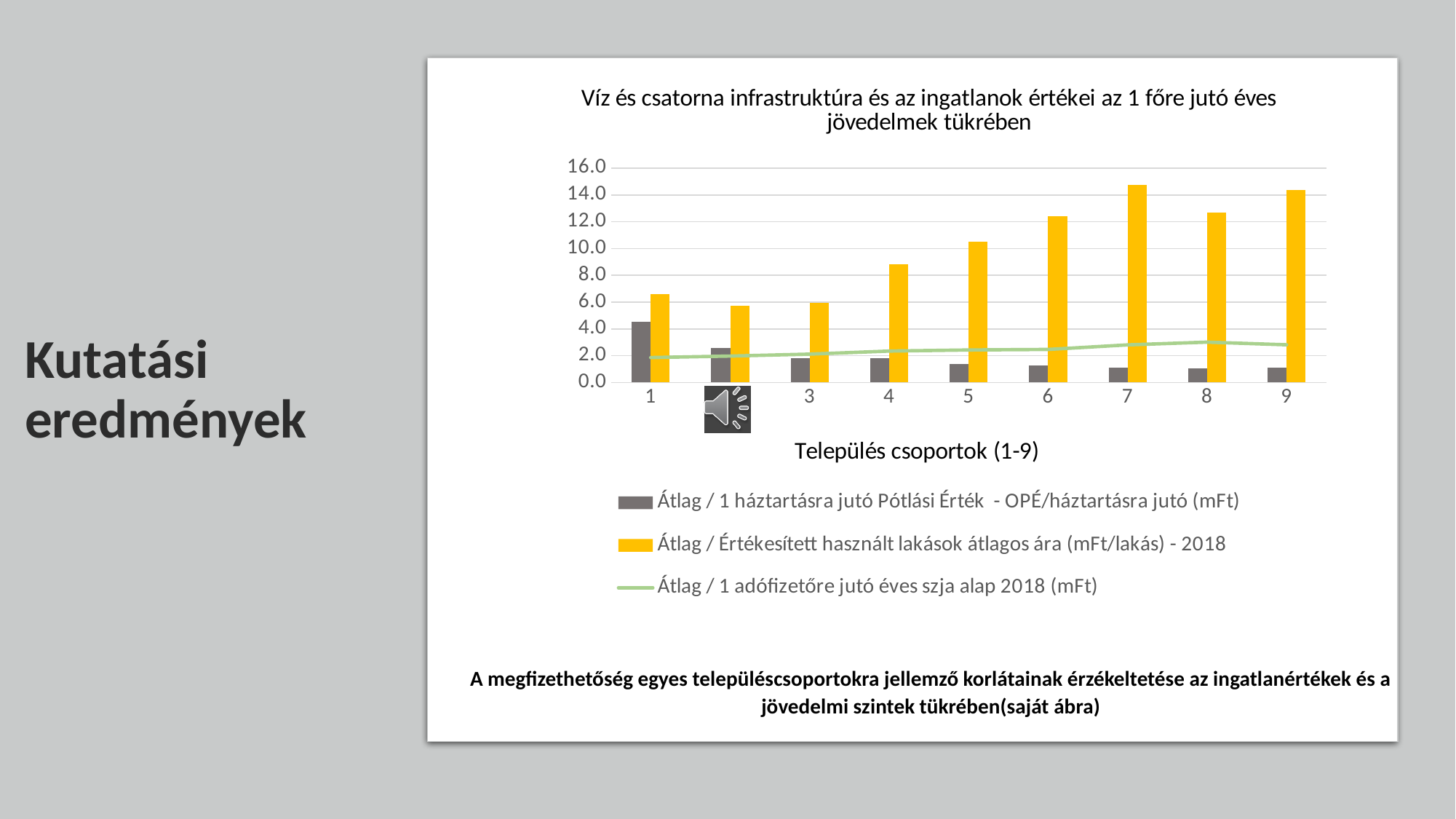
Is the grey bar (Pótlási Érték) for settlement group 1 greater or less than 4.0? greater Is the yellow bar (Értékesített használt lakások átlagos ára) for settlement group 4 greater or less than 10.0? less Which series is drawn as a green line? Átlag / 1 adófizetőre jutó éves szja alap 2018 (mFt) What kind of chart is shown on the slide? A combined bar and line chart What is the title of the x axis? Település csoportok (1-9) Is the green line value (éves szja alap 2018) for settlement group 9 greater or less than 2.0? greater Do the grey bars (Pótlási Érték) generally rise or fall from settlement group 1 to 9? fall How many settlement groups (categories) are plotted along the x axis? 9 How many series does the legend list? 3 Which is larger: the yellow bar for settlement group 4 or the yellow bar for settlement group 5? Settlement group 5 Which settlement group has the highest value for the grey series (Átlag / 1 háztartásra jutó Pótlási Érték)? 1